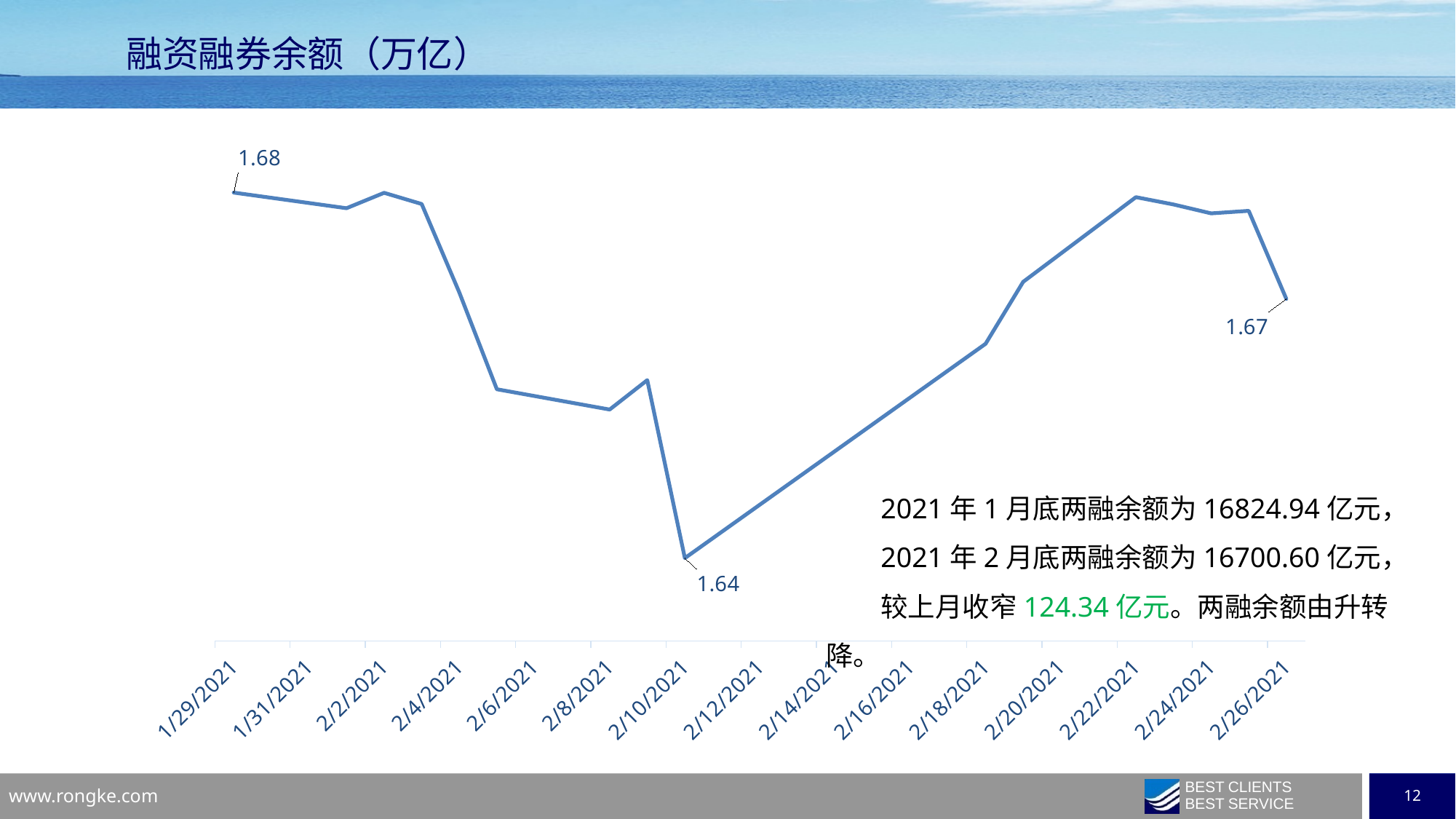
What is the difference between the values for 1/29/2021 and 2/10/2021? 0.04 Which is larger, the value for 1/29/2021 or the value for 2/26/2021? 1/29/2021 Which is larger, the value for 2/10/2021 or the value for 2/26/2021? 2/26/2021 How many date labels are shown on the x axis? 15 What kind of chart is shown on the slide? line chart What is the value for 2/10/2021? 1.64 What is the value for 1/29/2021? 1.68 What is the value for 2/26/2021? 1.67 On which date is the value lowest? 2/10/2021 What is the difference between the values for 1/29/2021 and 2/26/2021? 0.01 Do the values rise or fall between 2/10/2021 and 2/22/2021? rise What is the title of the chart? 融资融券余额（万亿）